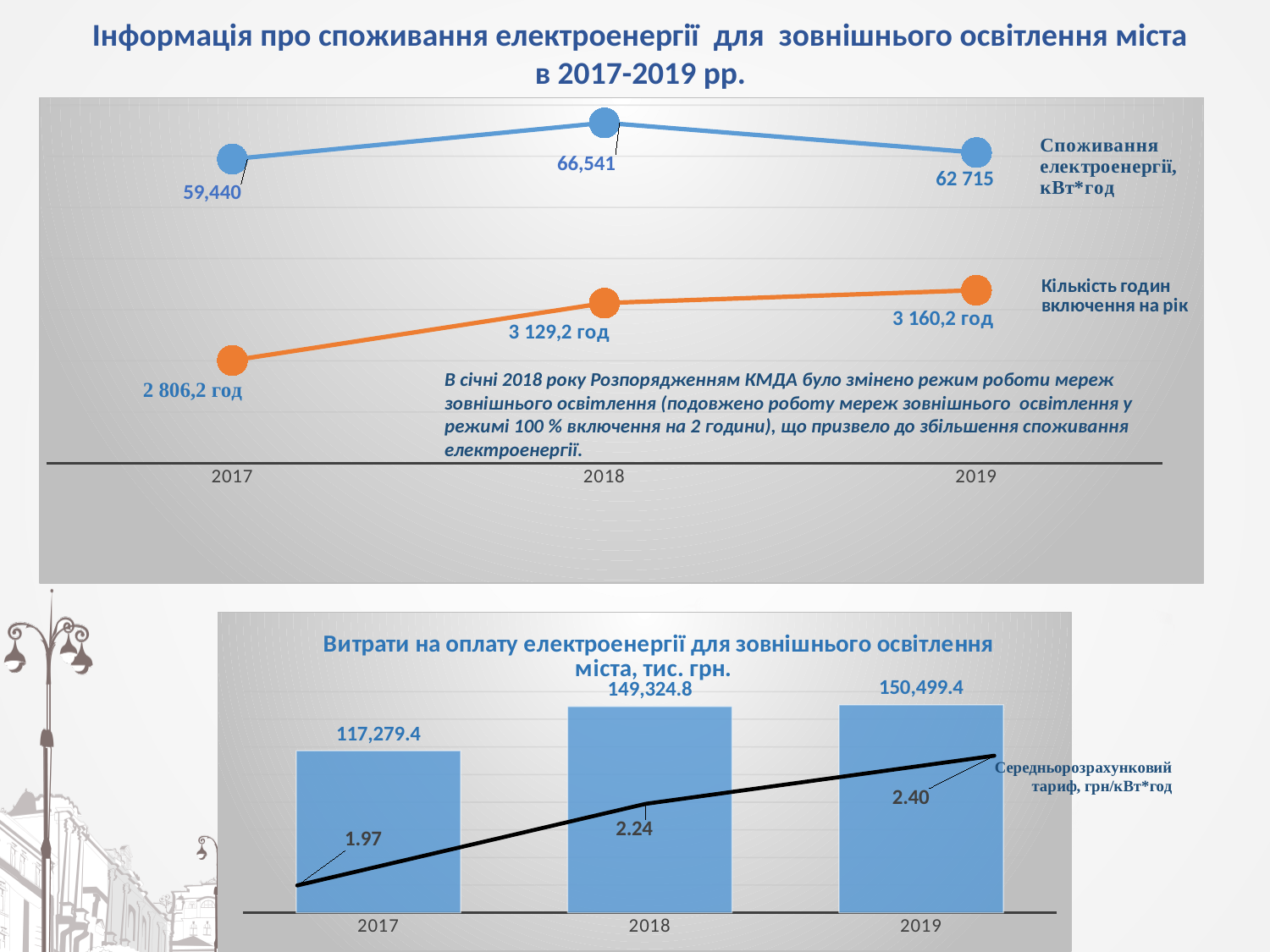
In the top chart, which year has the highest electricity consumption? 2018 In the bottom chart, does the average tariff rise or fall from 2017 to 2019? rise In the bottom chart 'Витрати на оплату електроенергії для зовнішнього освітлення міста, тис. грн.', what is the value for 2017? 117,279.4 In the top chart, how many data series are shown? 2 In the top chart, what is the number of hours of switching on per year (Кількість годин включення на рік) for 2017? 2 806,2 год What type of chart is used for the expenses in the bottom chart? bar chart In the bottom chart, what is the average tariff (Середньорозрахунковий тариф, грн/кВт*год) for 2019? 2.40 In the top chart, what is the electricity consumption (Споживання електроенергії, кВт*год) for 2018? 66,541 In the bottom chart, which year has the highest expenses on electricity? 2019 In the top chart, which year has the lowest number of hours of switching on per year? 2017 In the top chart, do the hours of switching on per year rise or fall from 2017 to 2019? rise In the bottom chart, what is the difference in expenses between 2018 and 2017? 32,045.4